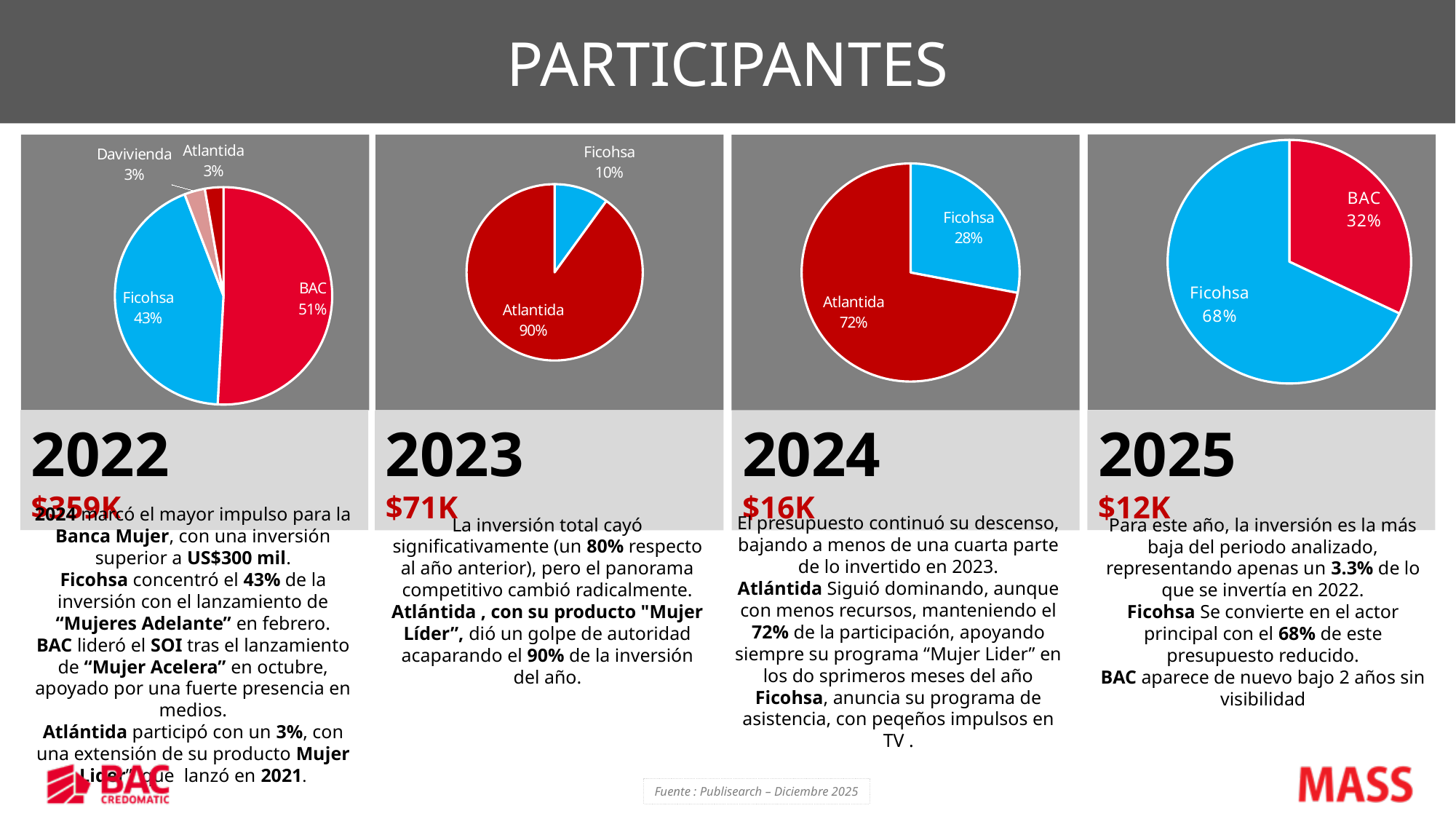
In the 2022 pie chart, what share does Ficohsa hold? 43% In the 2025 pie chart, which is larger, BAC's share or Ficohsa's share? Ficohsa In the 2022 pie chart, which participant has the largest share? BAC What kind of chart is used for each year on the slide? Pie chart In the 2023 pie chart, what share does Atlantida hold? 90% In the 2022 pie chart, how many slices are there? 4 How many pie charts are shown on the slide? 4 In the 2025 pie chart, what share does Ficohsa hold? 68% In the 2024 pie chart, what share does Ficohsa hold? 28% In the 2023 pie chart, what is the difference between Atlantida's share and Ficohsa's share? 80% In the 2024 pie chart, which participant has the smallest share? Ficohsa In the 2022 pie chart, what share does BAC hold? 51%